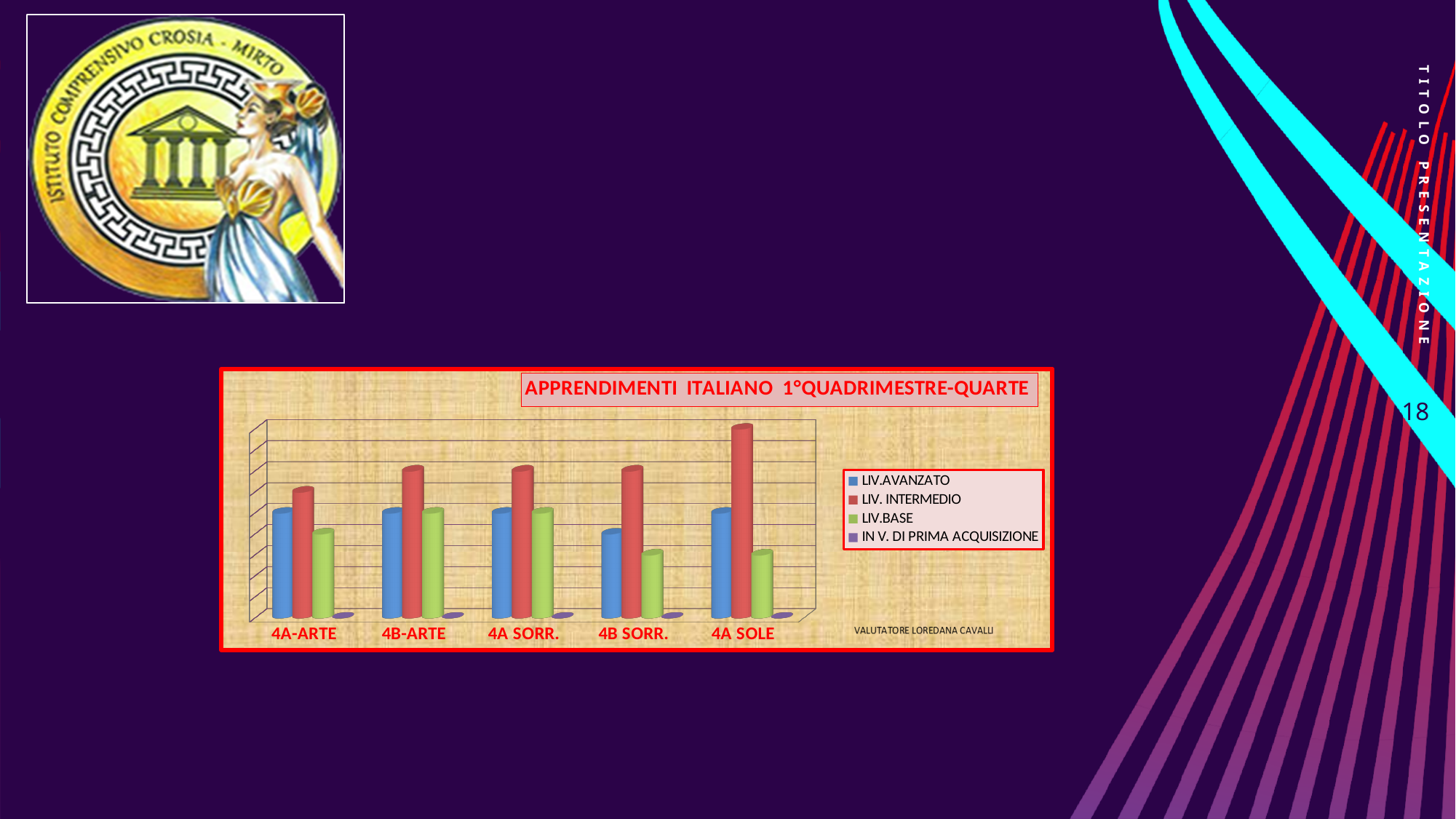
Which class has the highest LIV. INTERMEDIO bar? 4A SOLE Which class has the lowest LIV. INTERMEDIO bar? 4A-ARTE For 4A SOLE, which is larger: LIV. INTERMEDIO or LIV.BASE? LIV. INTERMEDIO How many series does the chart legend list? 4 For 4A-ARTE, which is larger: LIV.AVANZATO or LIV. INTERMEDIO? LIV. INTERMEDIO Which class has the lowest LIV.AVANZATO bar? 4B SORR. For 4A SOLE, which series has the lowest value? IN V. DI PRIMA ACQUISIZIONE For 4B SORR., which is larger: LIV.AVANZATO or LIV.BASE? LIV.AVANZATO How many classes (categories) are shown on the x axis of the chart? 5 Which series is shown in red in the chart? LIV. INTERMEDIO What is the title of the chart? APPRENDIMENTI ITALIANO 1°QUADRIMESTRE-QUARTE What kind of chart is shown on the slide? Bar chart